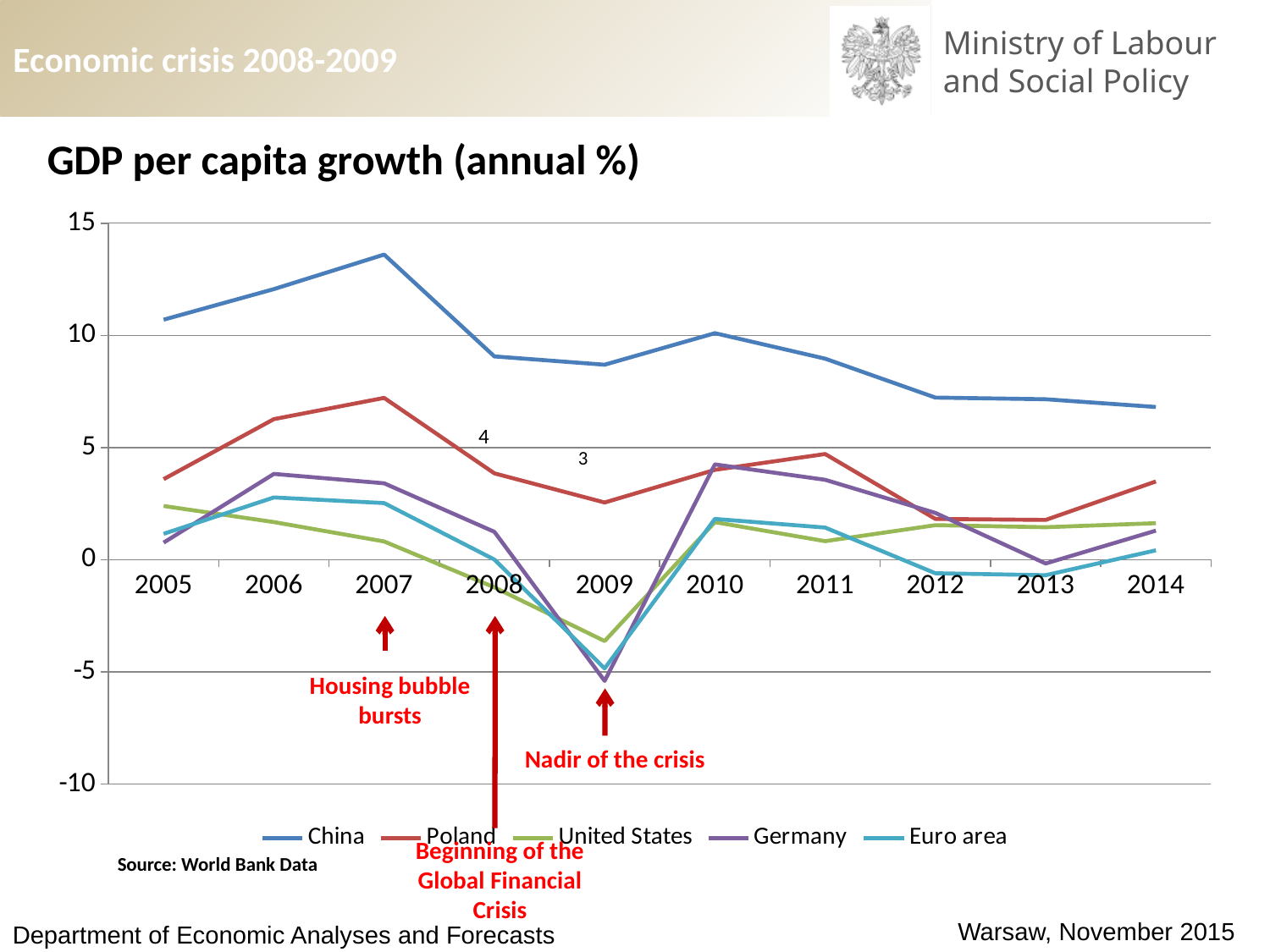
In which year does the United States line reach its lowest value? 2009 How many years are shown along the x axis? 10 Is the value for China in 2005 greater or less than 10? greater How many series does the legend list? 5 In which year does the China line reach its highest value? 2007 Is the value for Poland in 2007 greater or less than 5? greater Which is larger in 2006, the value for Germany or the value for Euro area? Germany Is the value for China in 2014 greater or less than 10? less Does the China line rise or fall from 2010 to 2014? fall Which is larger in 2010, the value for China or the value for Poland? China What kind of chart is shown on the slide? line chart What is the title of the chart? GDP per capita growth (annual %)